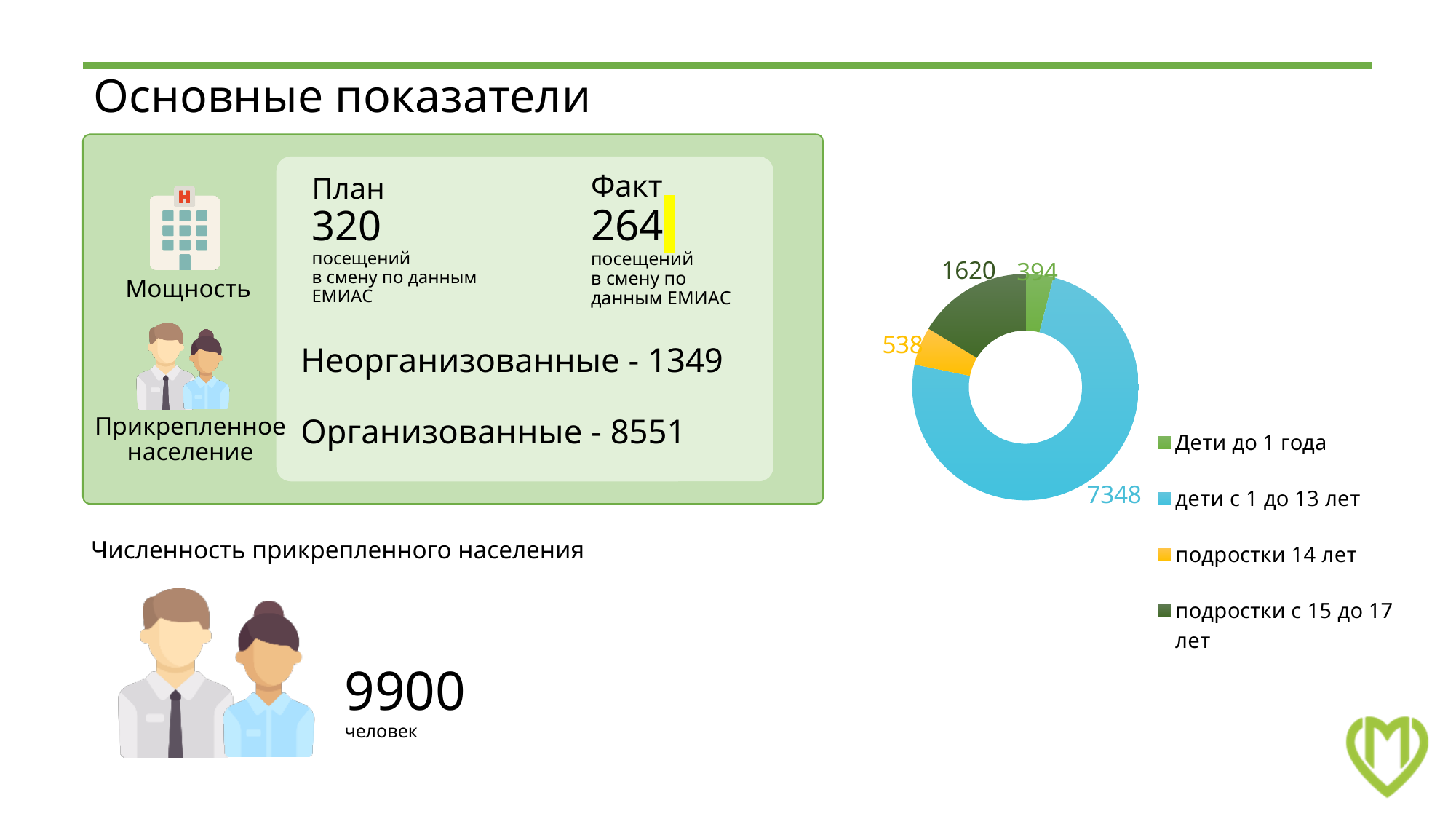
In the donut chart, what is the difference between the values for 'дети с 1 до 13 лет' and 'подростки с 15 до 17 лет'? 5728 In the donut chart, what is the value for 'подростки 14 лет'? 538 What kind of chart is shown on the right side of the slide? Donut (pie) chart How many categories does the donut chart's legend list? 4 In the donut chart, what is the difference between the values for 'подростки 14 лет' and 'Дети до 1 года'? 144 Which category has the smallest slice in the donut chart? Дети до 1 года Which category has the largest slice in the donut chart? дети с 1 до 13 лет In the donut chart, what is the value for 'Дети до 1 года'? 394 In the donut chart, what is the value for 'дети с 1 до 13 лет'? 7348 In the donut chart, what is the value for 'подростки с 15 до 17 лет'? 1620 In the donut chart, which is larger: 'подростки с 15 до 17 лет' or 'подростки 14 лет'? подростки с 15 до 17 лет What is the total of all four values shown in the donut chart? 9900